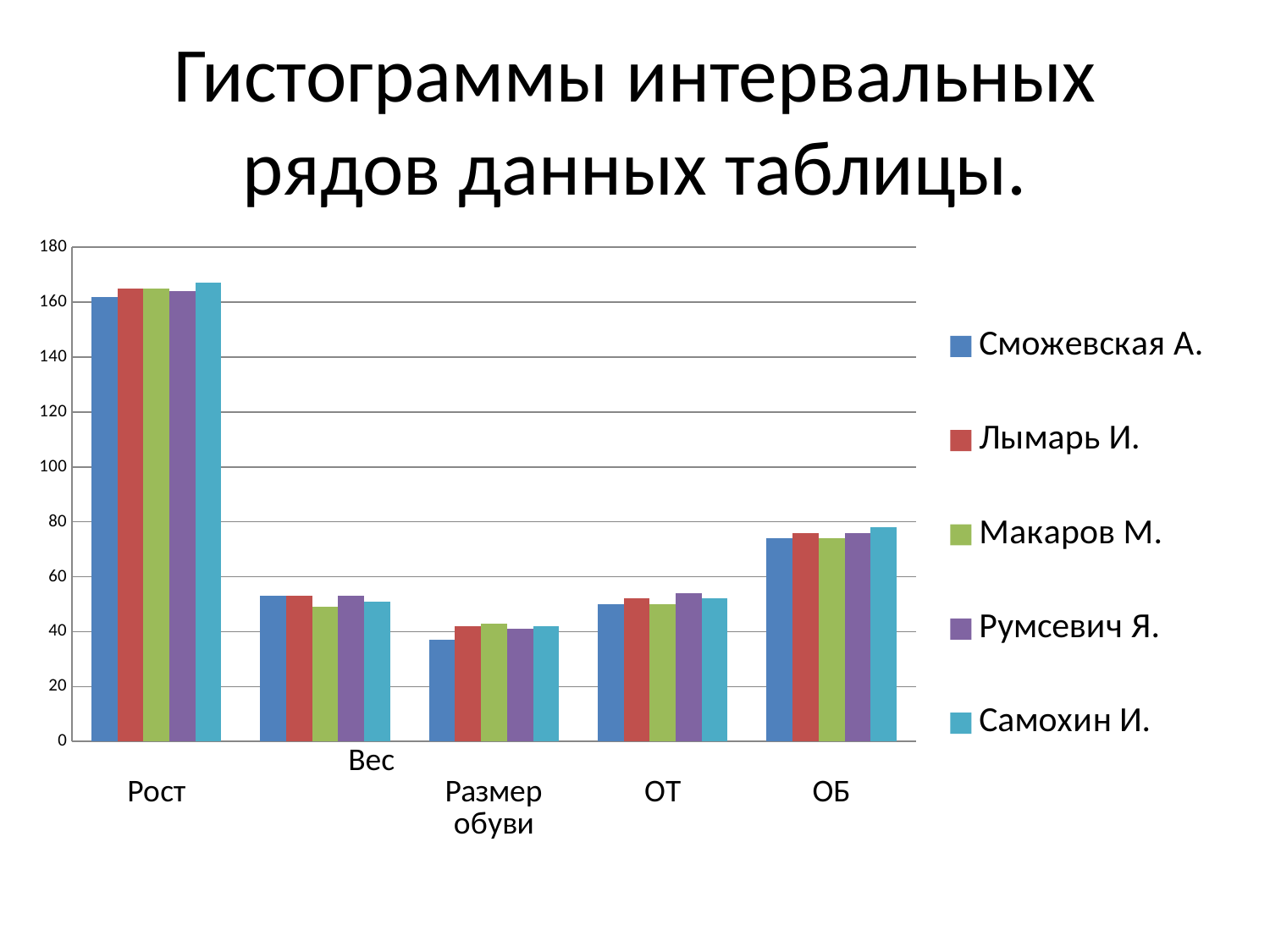
Which category has the lowest values in the chart? Размер обуви What is the title of the slide? Гистограммы интервальных рядов данных таблицы. What kind of chart is shown on the slide? bar chart How many categories are shown on the x axis of the chart? 5 Is the value for Лымарь И. in the Вес category greater or less than 60? less Within the Размер обуви category, which series has the lowest bar? Сможевская А. Is the value for Сможевская А. in the Размер обуви category greater or less than 40? less Which is larger for Макаров М.: the value for Рост or the value for ОБ? Рост Is the value for Самохин И. in the Рост category greater or less than 160? greater Which category has the highest values in the chart? Рост How many series does the legend list? 5